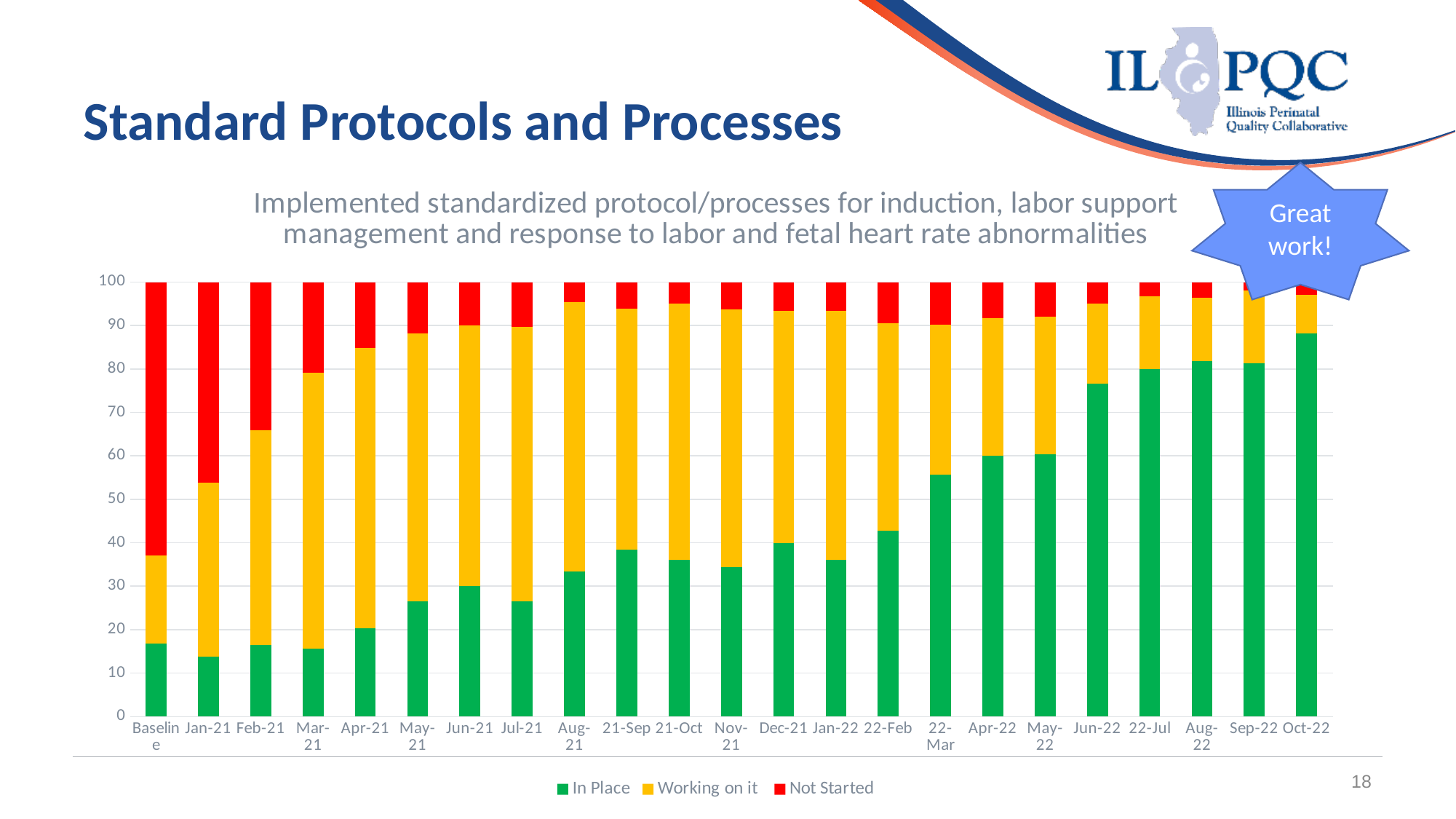
Which category has the highest 'In Place' value? Oct-22 Is the 'In Place' value for Baseline greater or less than 20? less Does the 'In Place' series generally rise or fall from Baseline to Oct-22? rise Which legend entry is shown in green? In Place How many series does the legend list? 3 What is the total of the stacked bar for Baseline? 100 Is the 'In Place' value for Jun-22 greater or less than 70? greater Which is larger, the 'In Place' value for Jun-22 or for Dec-21? Jun-22 How many time-period categories are shown along the x axis? 23 Which category has the largest 'Not Started' segment? Baseline What kind of chart is shown on the slide? Stacked bar chart Is the 'In Place' value for Oct-22 greater or less than 80? greater